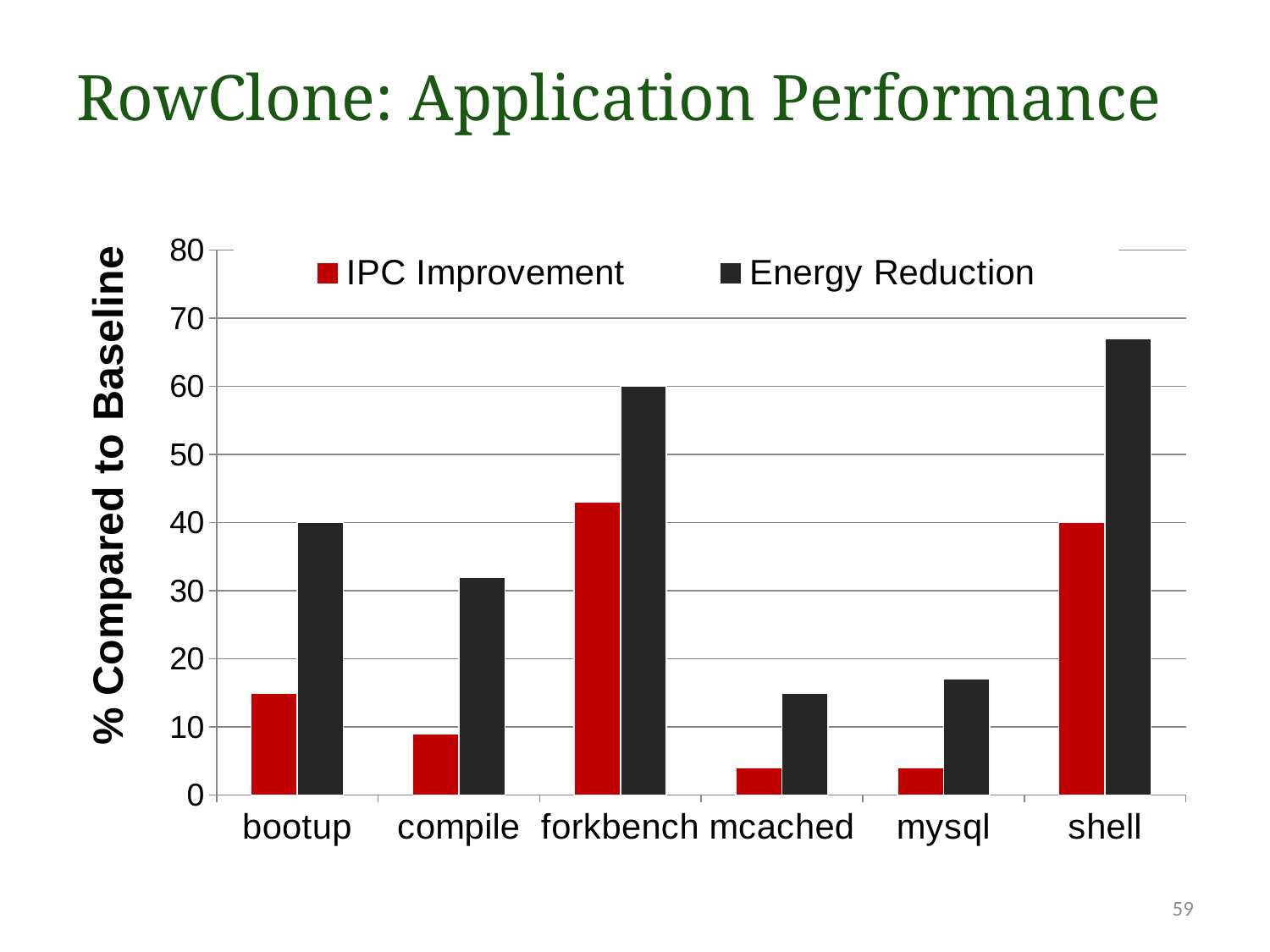
How many applications are shown along the x axis? 6 What kind of chart is shown on the slide? bar chart How many series does the legend list? 2 For bootup, which is larger: IPC Improvement or Energy Reduction? Energy Reduction Which application has the highest IPC Improvement? forkbench Is the IPC Improvement for compile greater or less than 10? less Is the IPC Improvement for mcached greater or less than 10? less Which has a larger Energy Reduction: compile or mysql? compile Is the Energy Reduction for compile greater or less than 30? greater Which application has the highest Energy Reduction? shell What is the label on the y axis? % Compared to Baseline